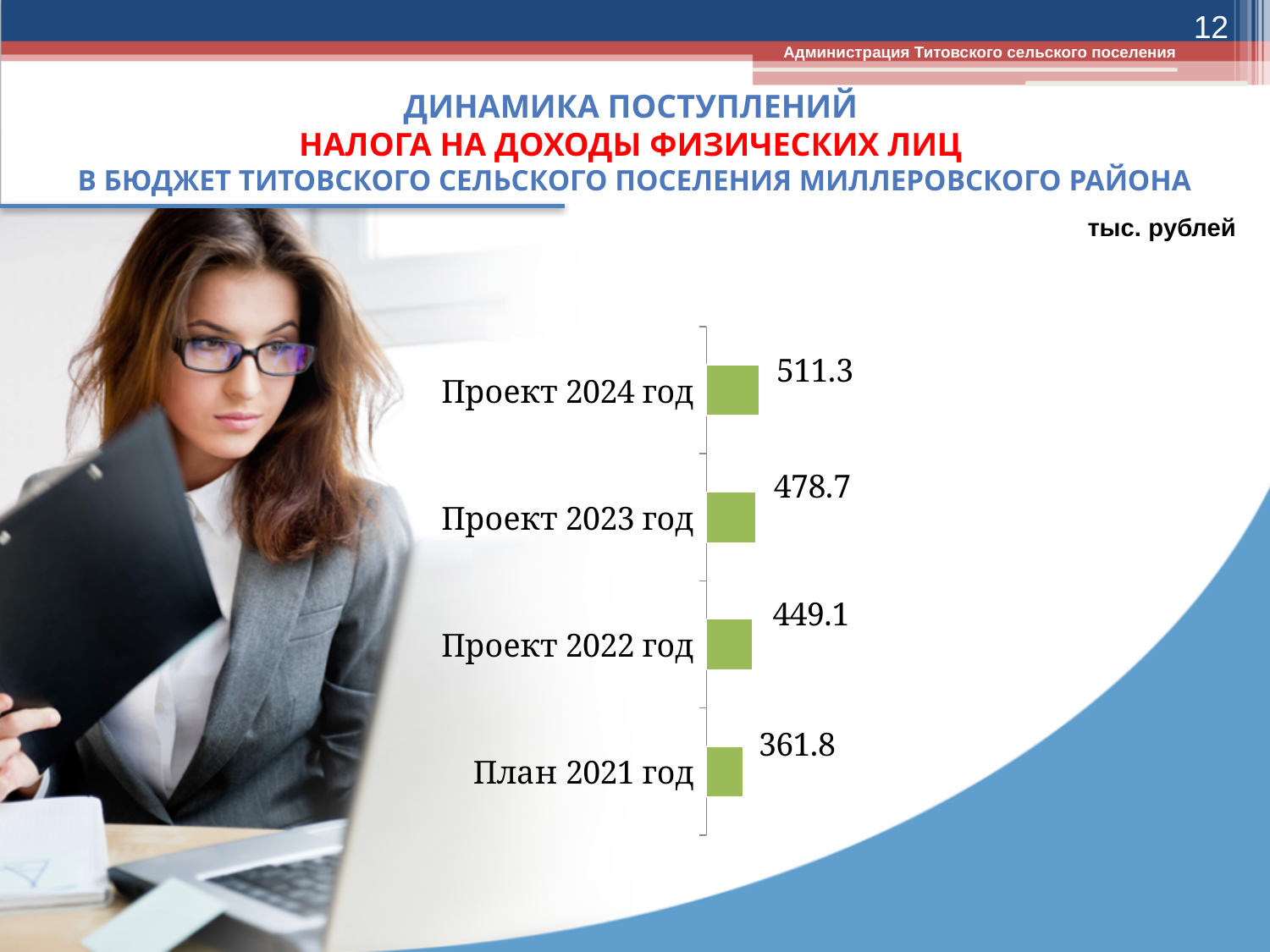
What is the value for Проект 2024 год? 511.3 How many categories are shown in the chart? 4 Which is larger, the value for Проект 2023 год or the value for Проект 2022 год? Проект 2023 год What is the difference between the values for Проект 2022 год and План 2021 год? 87.3 What is the value for План 2021 год? 361.8 What kind of chart is shown on the slide? Bar chart In what units are the chart values given? тыс. рублей Do the values rise or fall from План 2021 год to Проект 2024 год? Rise What is the value for Проект 2022 год? 449.1 What is the difference between the values for Проект 2024 год and Проект 2023 год? 32.6 Which category has the lowest value? План 2021 год Which category has the highest value? Проект 2024 год